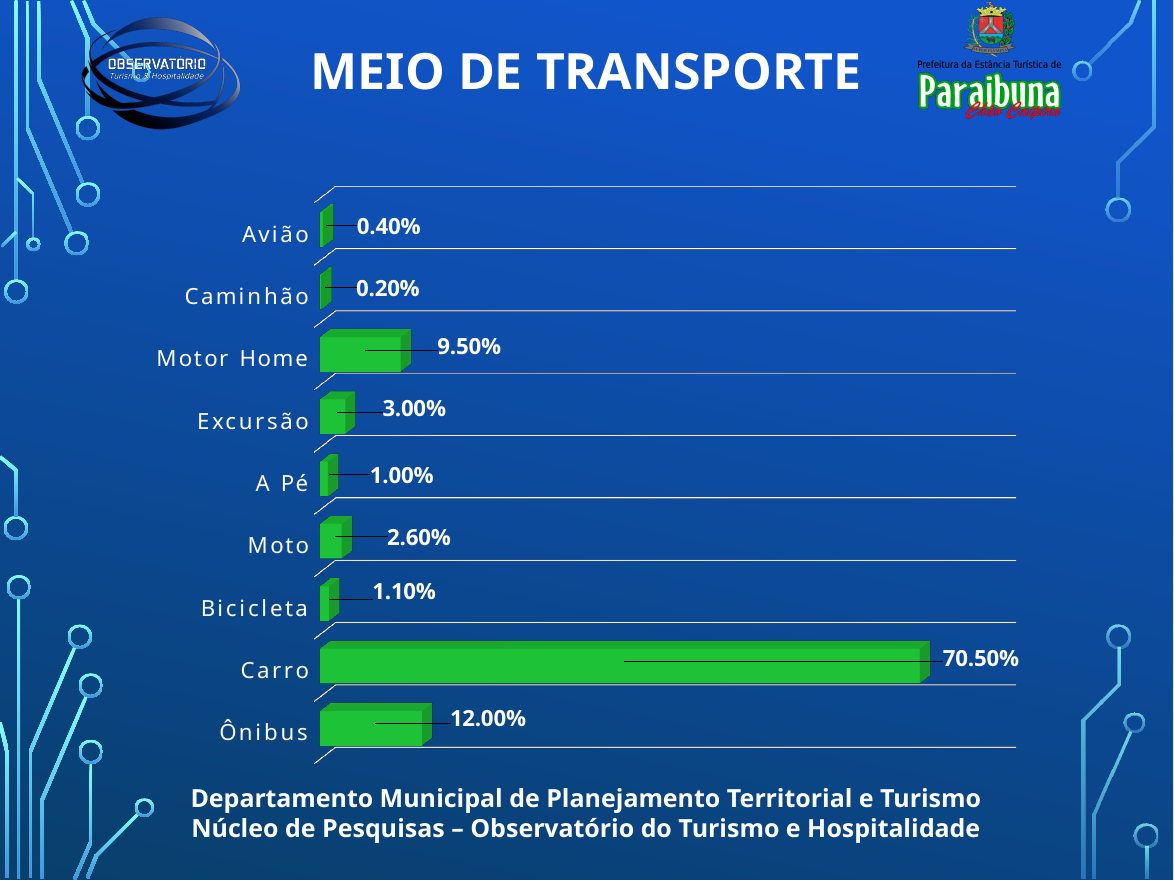
Which category has the lowest value? Caminhão How many categories are shown in the chart? 9 What is the difference between the values for Moto and Bicicleta? 1.50% What is the value for Ônibus? 12.00% What kind of chart is shown on the slide? Bar chart What is the value for Caminhão? 0.20% Which category has the highest value? Carro What is the value for Motor Home? 9.50% What is the difference between the values for Carro and Ônibus? 58.50% What is the value for Carro? 70.50% What is the title of the slide? MEIO DE TRANSPORTE Which is larger, the value for Excursão or the value for Moto? Excursão